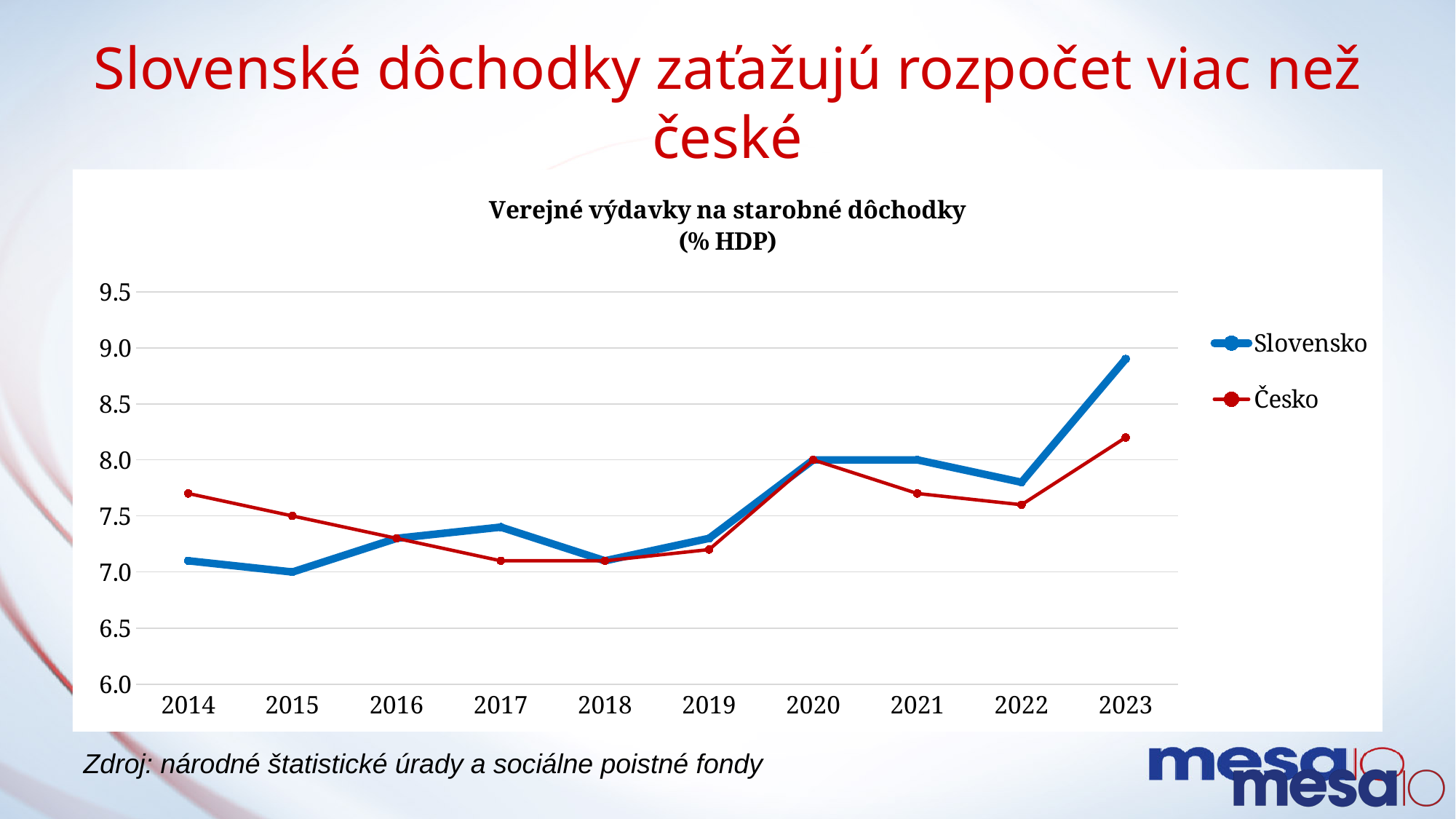
In which year does the Česko series reach its highest value? 2023 How many series does the legend list? 2 Is the value for Slovensko in 2023 greater or less than 8.5? greater Is the value for Slovensko in 2022 greater or less than 8.0? less In which year does the Slovensko series reach its highest value? 2023 In 2014, which series has the higher value, Slovensko or Česko? Česko Is the value for Česko in 2017 greater or less than 7.5? less How many years are plotted on the x axis? 10 What is the title of the chart? Verejné výdavky na starobné dôchodky (% HDP) In which year does the Slovensko series reach its lowest value? 2015 In 2023, which series has the higher value, Slovensko or Česko? Slovensko What kind of chart is shown on the slide? line chart